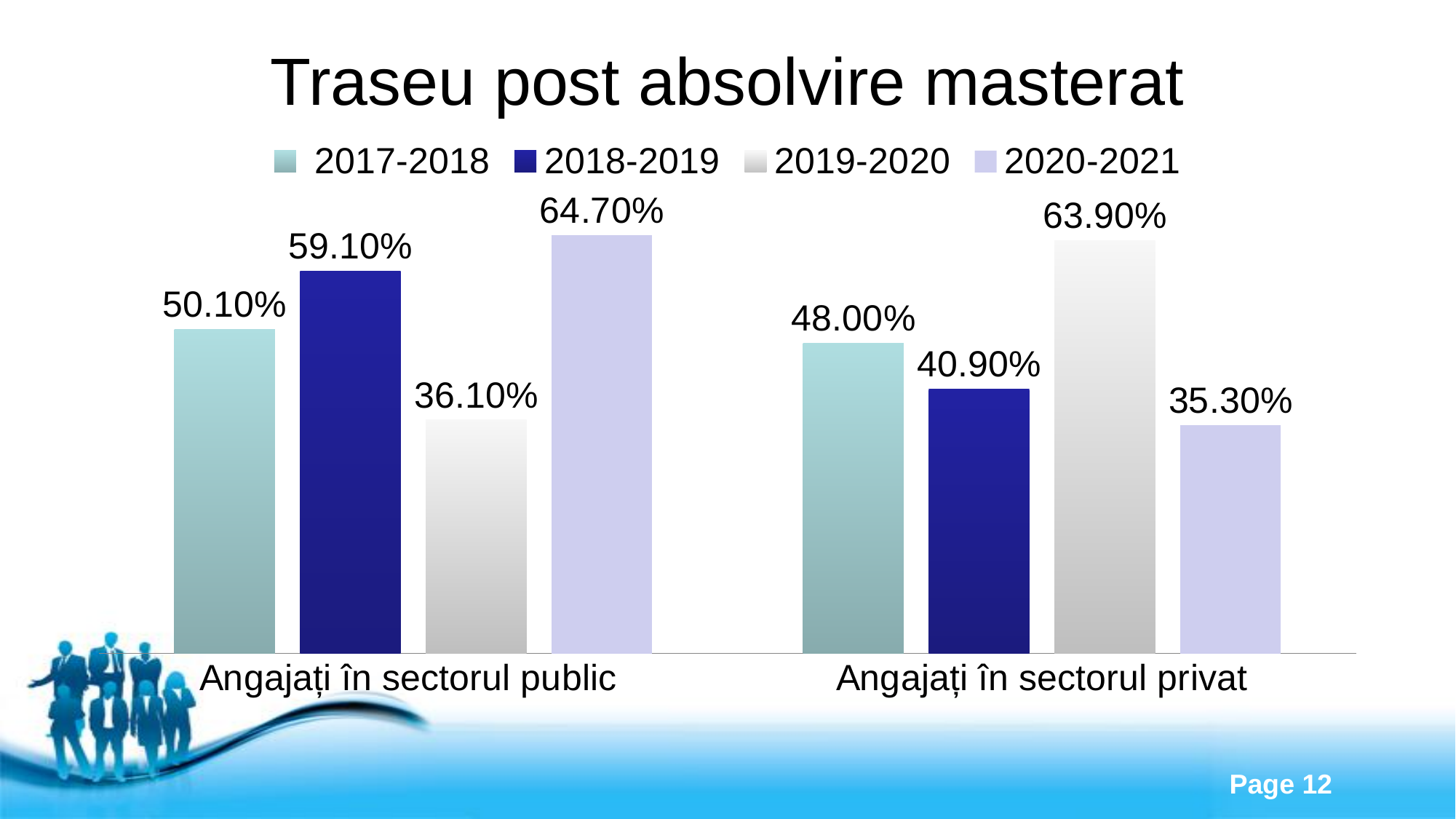
How many categories are shown on the x axis? 2 What is the title of the chart? Traseu post absolvire masterat What is the value for 2018-2019 in the 'Angajați în sectorul privat' category? 40.90% Which series has the lowest value in the 'Angajați în sectorul privat' category? 2020-2021 What is the value for 2020-2021 in the 'Angajați în sectorul public' category? 64.70% What is the difference between the 2020-2021 and 2019-2020 values in the 'Angajați în sectorul public' category? 28.60% What is the value for 2019-2020 in the 'Angajați în sectorul privat' category? 63.90% What is the value for 2017-2018 in the 'Angajați în sectorul public' category? 50.10% Which is larger: the 2017-2018 value for 'Angajați în sectorul public' or for 'Angajați în sectorul privat'? Angajați în sectorul public What kind of chart is shown on the slide? Bar chart Which series has the highest value in the 'Angajați în sectorul public' category? 2020-2021 How many series does the legend list? 4